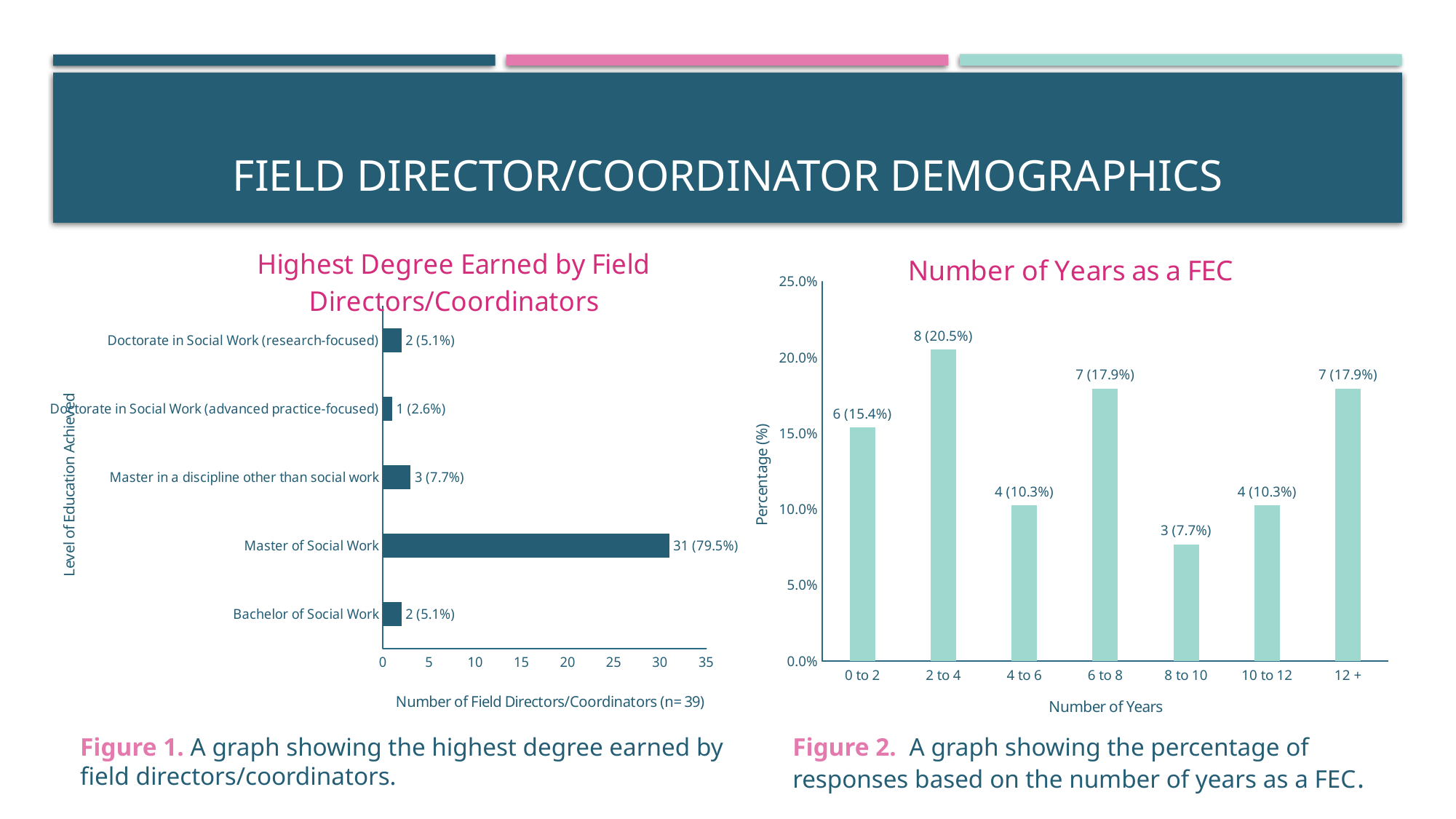
What is the x-axis title of the 'Highest Degree Earned by Field Directors/Coordinators' chart? Number of Field Directors/Coordinators (n= 39) In the 'Number of Years as a FEC' chart, which is larger: the value for 0 to 2 or the value for 4 to 6? 0 to 2 In the 'Number of Years as a FEC' chart, what is the data label for 2 to 4 years? 8 (20.5%) In the 'Number of Years as a FEC' chart, how many categories are shown on the x axis? 7 In the 'Number of Years as a FEC' chart, what is the difference in percentage between 2 to 4 and 8 to 10? 12.8% In the 'Highest Degree Earned by Field Directors/Coordinators' chart, how many categories are shown? 5 In the 'Highest Degree Earned by Field Directors/Coordinators' chart, which category has the lowest value? Doctorate in Social Work (advanced practice-focused) In the 'Highest Degree Earned by Field Directors/Coordinators' chart, what is the difference in count between Master of Social Work and Master in a discipline other than social work? 28 In the 'Highest Degree Earned by Field Directors/Coordinators' chart, what is the data label for Master of Social Work? 31 (79.5%) In the 'Number of Years as a FEC' chart, which category has the highest value? 2 to 4 In the 'Number of Years as a FEC' chart, which category has the lowest value? 8 to 10 What kind of chart is the 'Highest Degree Earned by Field Directors/Coordinators' chart? Bar chart